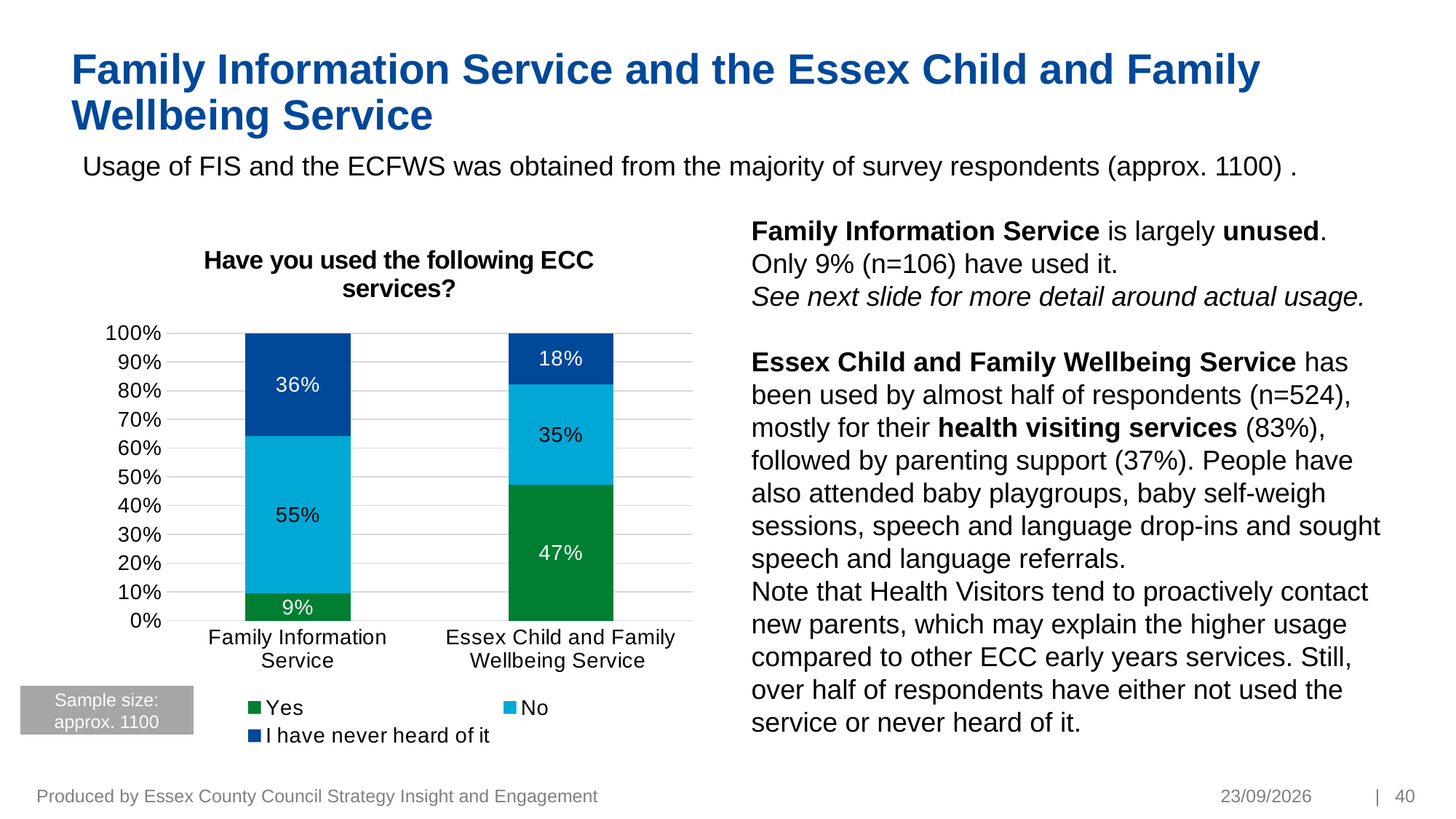
What is the difference between the 'Yes' percentages for the two services? 38% What percentage of respondents answered 'No' for the Essex Child and Family Wellbeing Service? 35% What percentage of respondents answered 'Yes' for the Essex Child and Family Wellbeing Service? 47% What kind of chart is shown on the slide? Stacked bar chart How many series does the legend list? 3 Which service has the higher 'Yes' percentage? Essex Child and Family Wellbeing Service What percentage of respondents said they have never heard of the Family Information Service? 36% What is the difference between the 'No' percentages for the Family Information Service and the Essex Child and Family Wellbeing Service? 20% Which service has the higher 'I have never heard of it' percentage? Family Information Service How many services (categories) are shown on the x axis? 2 What percentage of respondents answered 'Yes' for the Family Information Service? 9% What is the title of the chart? Have you used the following ECC services?